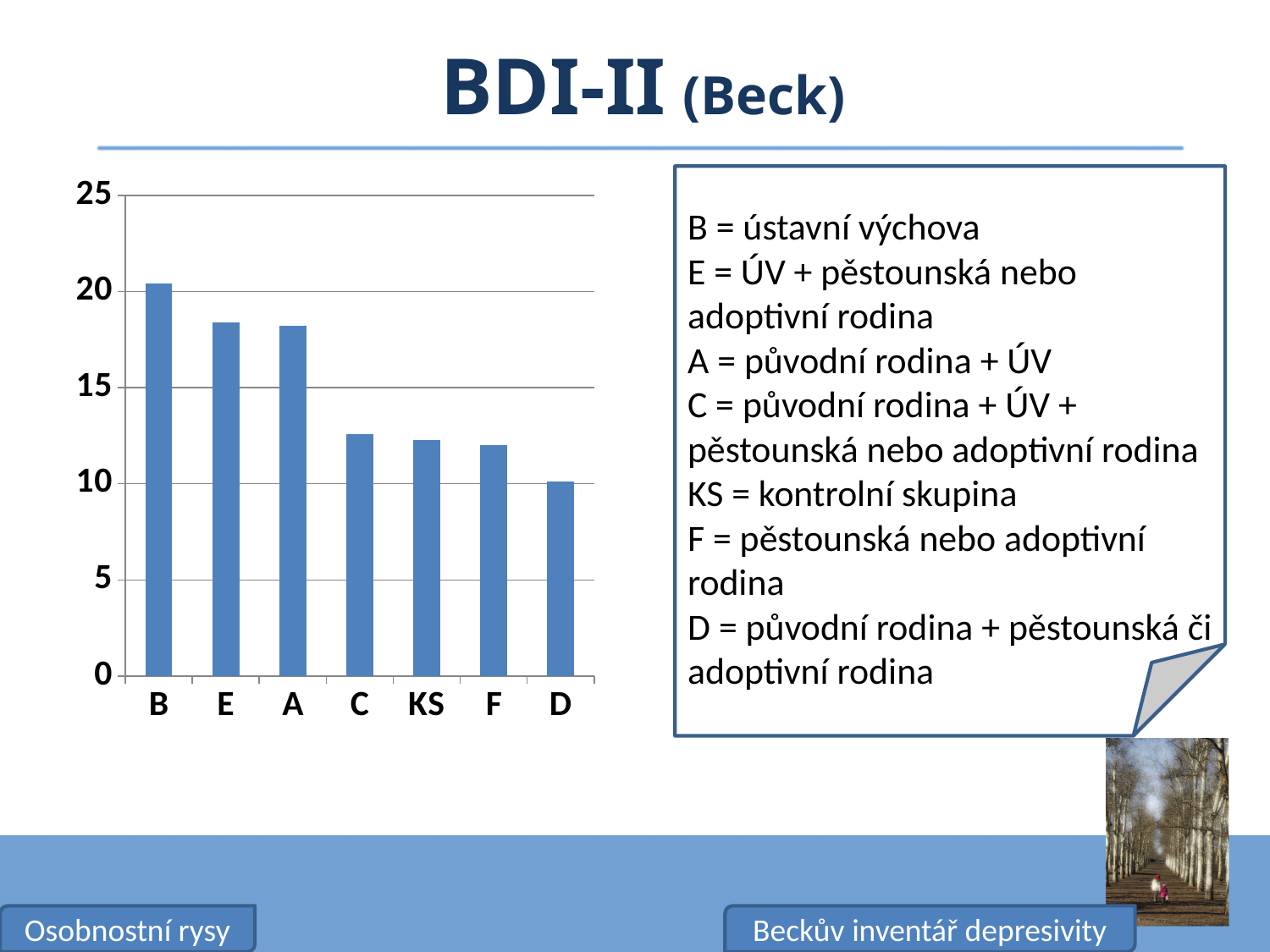
What is the title of the slide containing the chart? BDI-II (Beck) Which category has the lowest value in the chart? D Which category has the highest value in the chart? B Is the value for C greater or less than 10? greater Is the value for E greater or less than 20? less Is the value for B greater or less than 20? greater Do the values generally rise or fall from left to right along the x axis? fall Which is larger, the value for B or the value for C? B What kind of chart is shown on the slide? bar chart Which is larger, the value for F or the value for D? F How many categories are shown on the x axis of the chart? 7